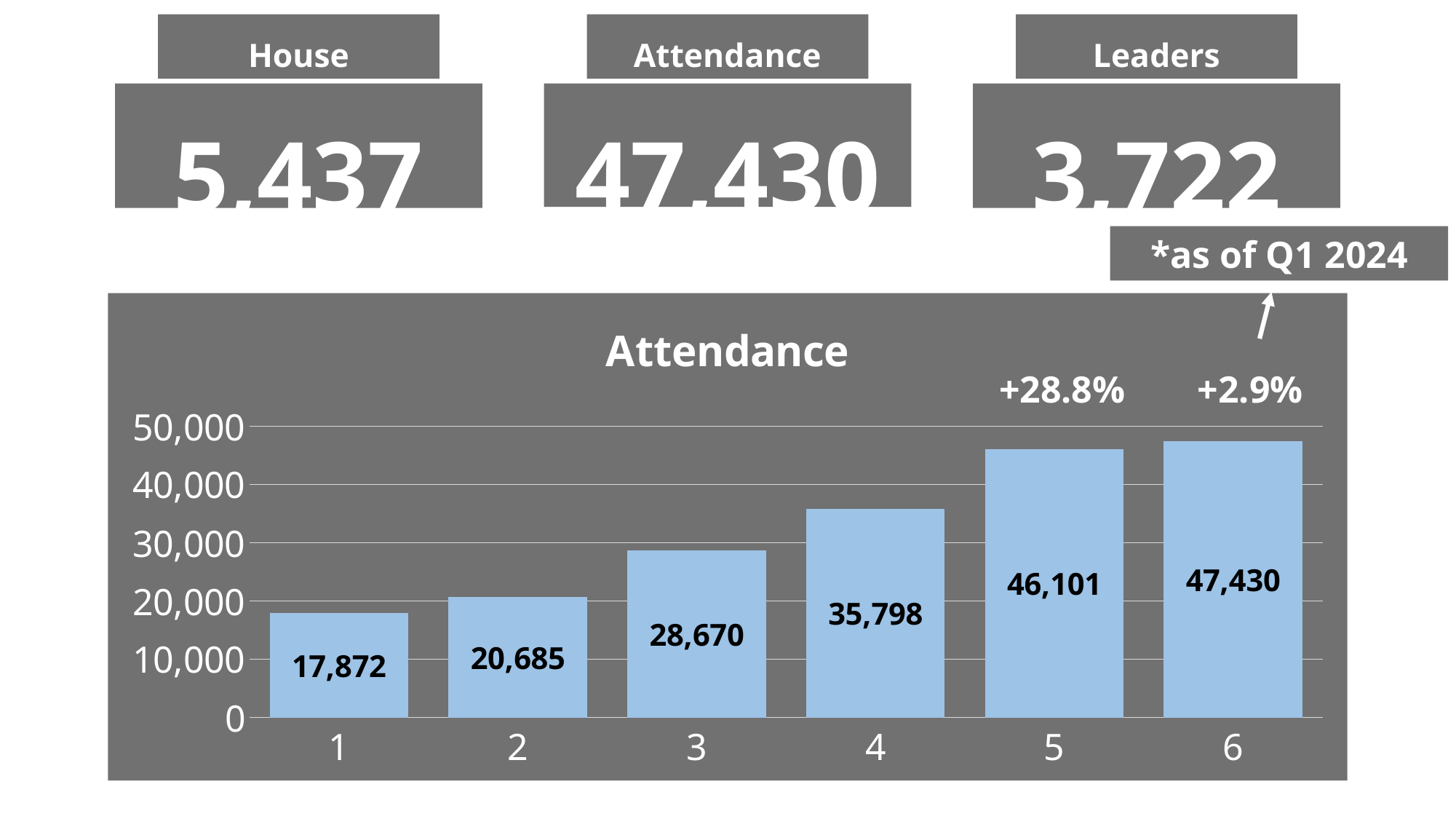
Which has a larger attendance value, category 2 or category 3? 3 What kind of chart is shown on the slide? bar chart Is the attendance value for category 4 greater or less than 30,000? greater What is the attendance value for category 1? 17,872 What is the attendance value for category 6? 47,430 What is the difference in attendance between category 6 and category 5? 1,329 Which category has the highest attendance? 6 What is the attendance value for category 4? 35,798 How many categories are shown on the x axis of the chart? 6 Which category has the lowest attendance? 1 What is the difference in attendance between category 3 and category 2? 7,985 Do the attendance values rise or fall from category 1 to category 6? rise